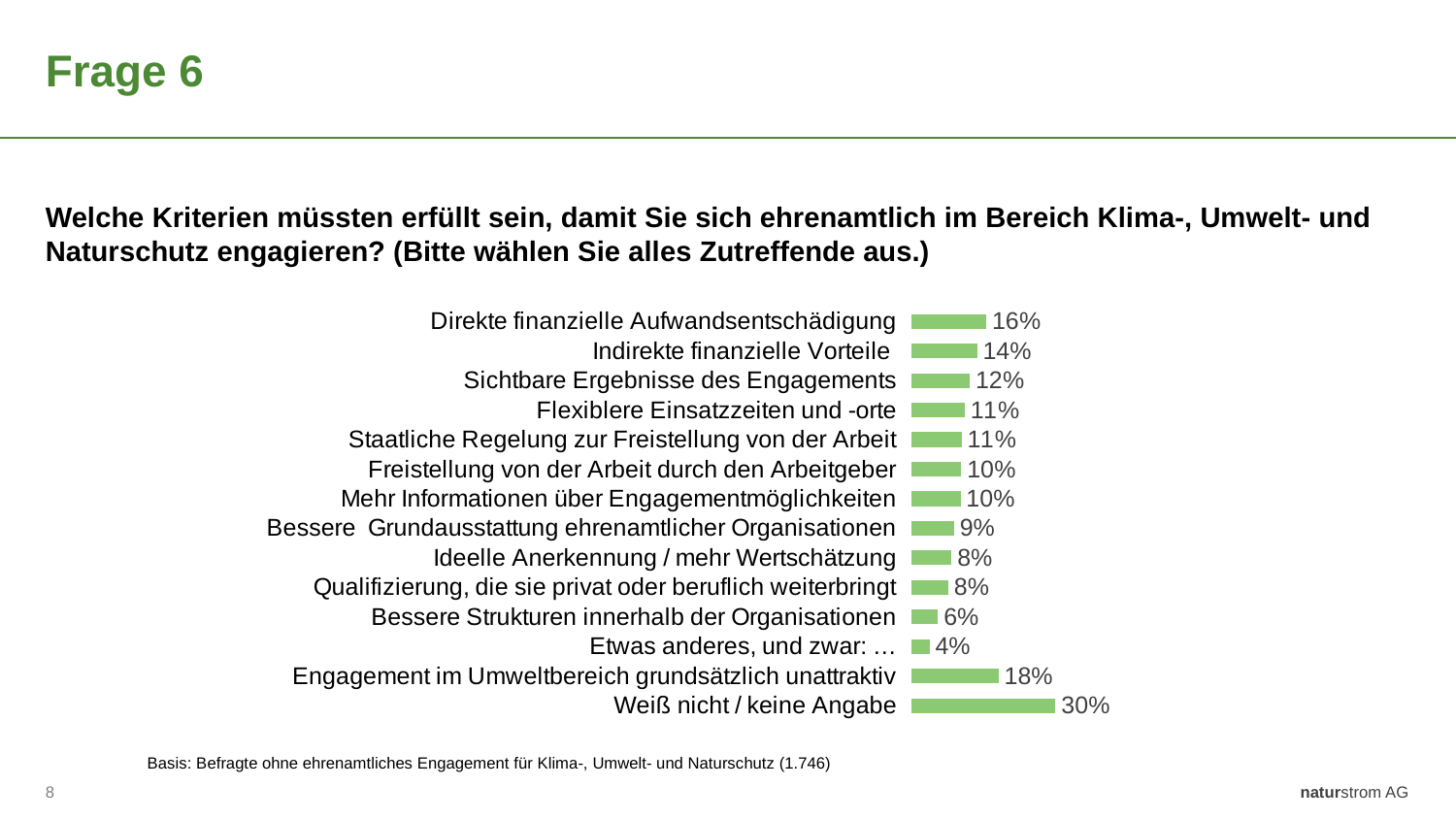
What is the value for "Direkte finanzielle Aufwandsentschädigung"? 16% What colour are the bars in the chart? Green What is the difference between "Weiß nicht / keine Angabe" and "Engagement im Umweltbereich grundsätzlich unattraktiv"? 12% What is the value for "Bessere Strukturen innerhalb der Organisationen"? 6% What is the difference between "Direkte finanzielle Aufwandsentschädigung" and "Indirekte finanzielle Vorteile"? 2% What is the value for "Weiß nicht / keine Angabe"? 30% What kind of chart is shown on the slide? Bar chart Which is larger: "Sichtbare Ergebnisse des Engagements" or "Ideelle Anerkennung / mehr Wertschätzung"? Sichtbare Ergebnisse des Engagements How many categories are shown in the chart? 14 What is the value for "Engagement im Umweltbereich grundsätzlich unattraktiv"? 18% Which category has the highest value? Weiß nicht / keine Angabe Which category has the lowest value? Etwas anderes, und zwar: …